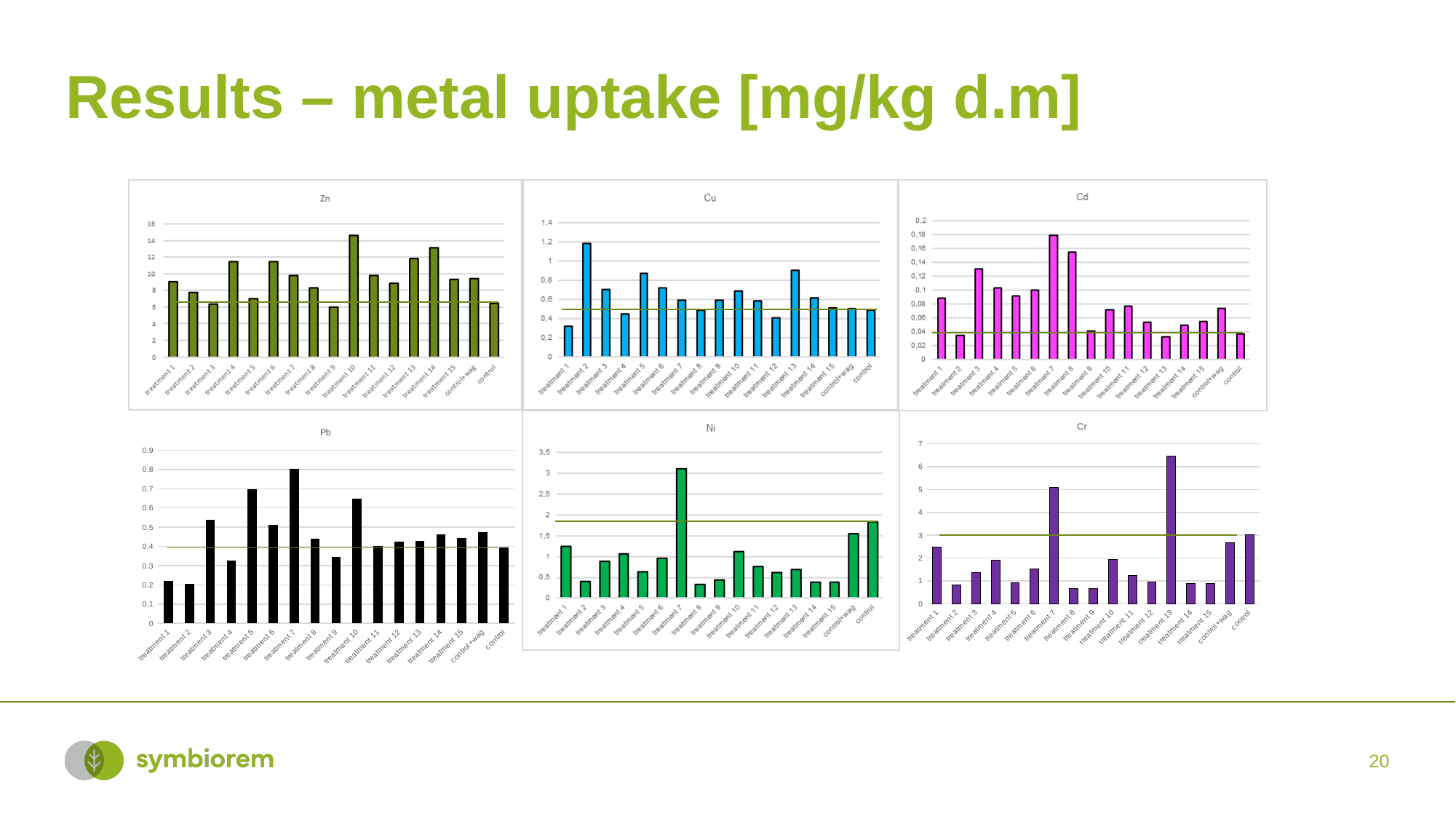
In the Pb chart, which is larger, treatment 5 or treatment 3? treatment 5 In the Ni chart, is the value for treatment 7 greater or less than 2.5? greater In the Zn chart, which category has the highest value? treatment 10 How many categories are plotted on the x axis of the Pb chart? 17 What kind of chart is the Zn chart? bar chart How many charts are shown on the slide? 6 In the Cr chart, is the value for treatment 7 greater or less than 4? greater In the Cu chart, is the value for treatment 2 greater or less than 1? greater In the Zn chart, which category has the lowest value? treatment 9 In the Cd chart, which category has the highest value? treatment 7 In the Cr chart, which category has the highest value? treatment 13